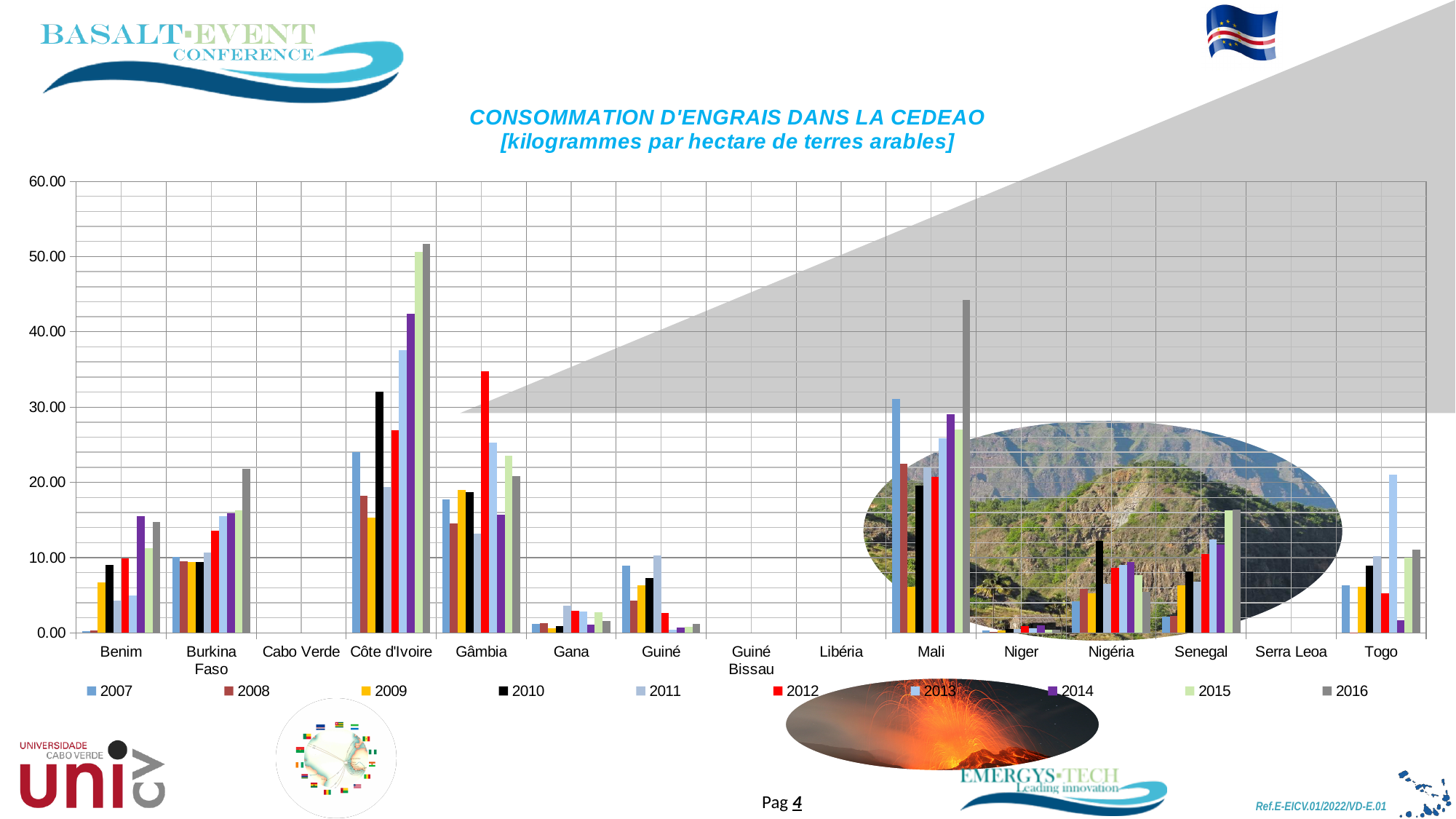
What is the title of the chart? CONSOMMATION D'ENGRAIS DANS LA CEDEAO Is the 2016 value for Mali greater or less than 40.00? greater In what unit are the values on the chart expressed, according to the subtitle? kilogrammes par hectare de terres arables How many series (years) does the legend list? 10 Is the 2011 value for Gana greater or less than 10.00? less What kind of chart is shown on the slide? bar chart Which country has the highest 2016 value? Côte d'Ivoire Which is larger, the 2010 value for Côte d'Ivoire or the 2010 value for Gâmbia? Côte d'Ivoire How many countries are listed along the x axis of the chart? 15 Is the 2013 value for Togo greater or less than 20.00? greater